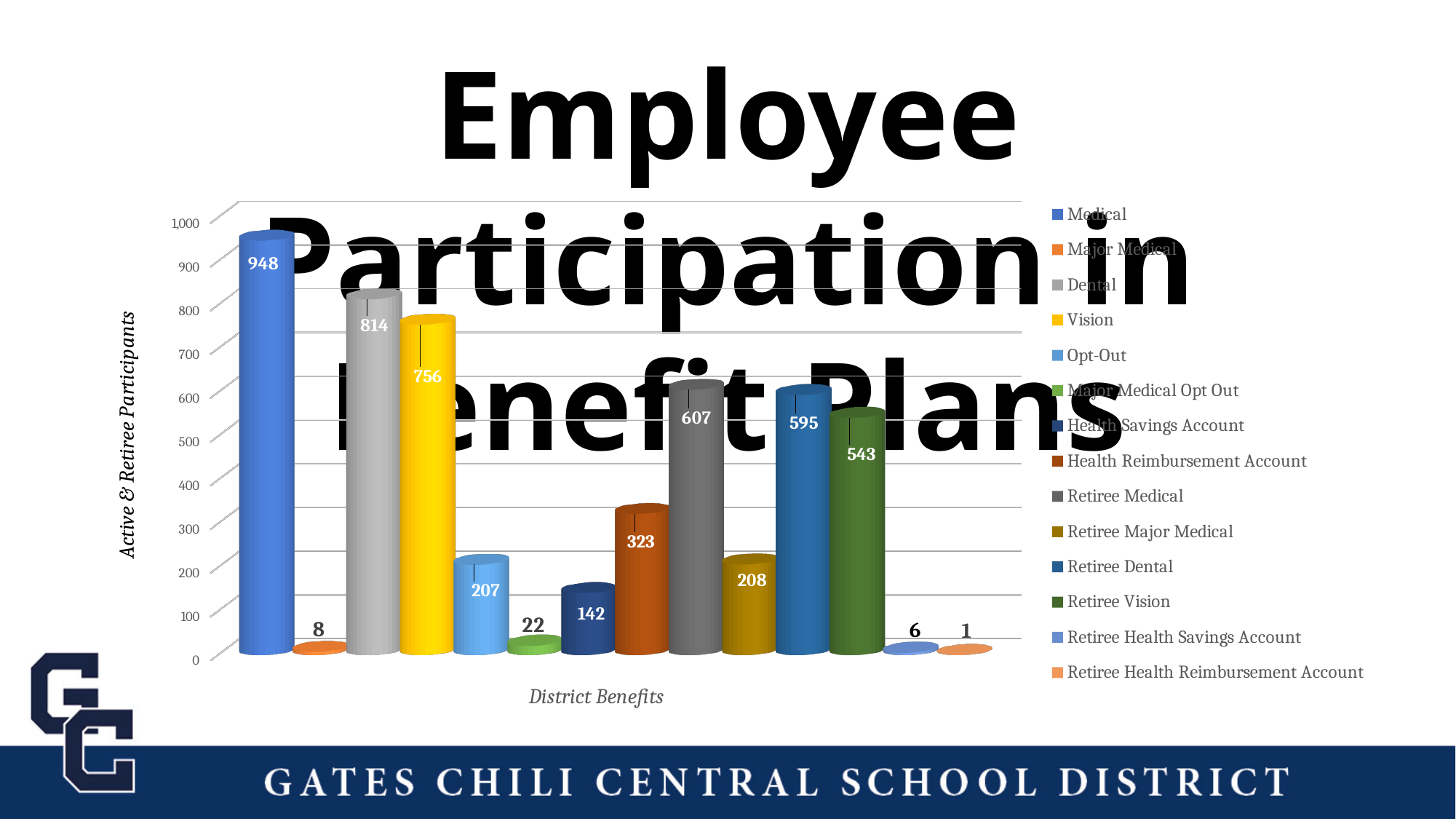
What is the label of the vertical axis? Active & Retiree Participants What is the label of the horizontal axis? District Benefits What is the value for Medical? 948 Which benefit plan has the lowest number of participants? Retiree Health Reimbursement Account Is the value for Opt-Out greater or less than 300? less What is the value for Retiree Vision? 543 Which benefit plan has the highest number of participants? Medical What is the value for Health Reimbursement Account? 323 How many series does the legend list? 14 Which is larger, Retiree Medical or Retiree Dental? Retiree Medical What kind of chart is shown on the slide? bar chart What is the difference between the values for Dental and Vision? 58